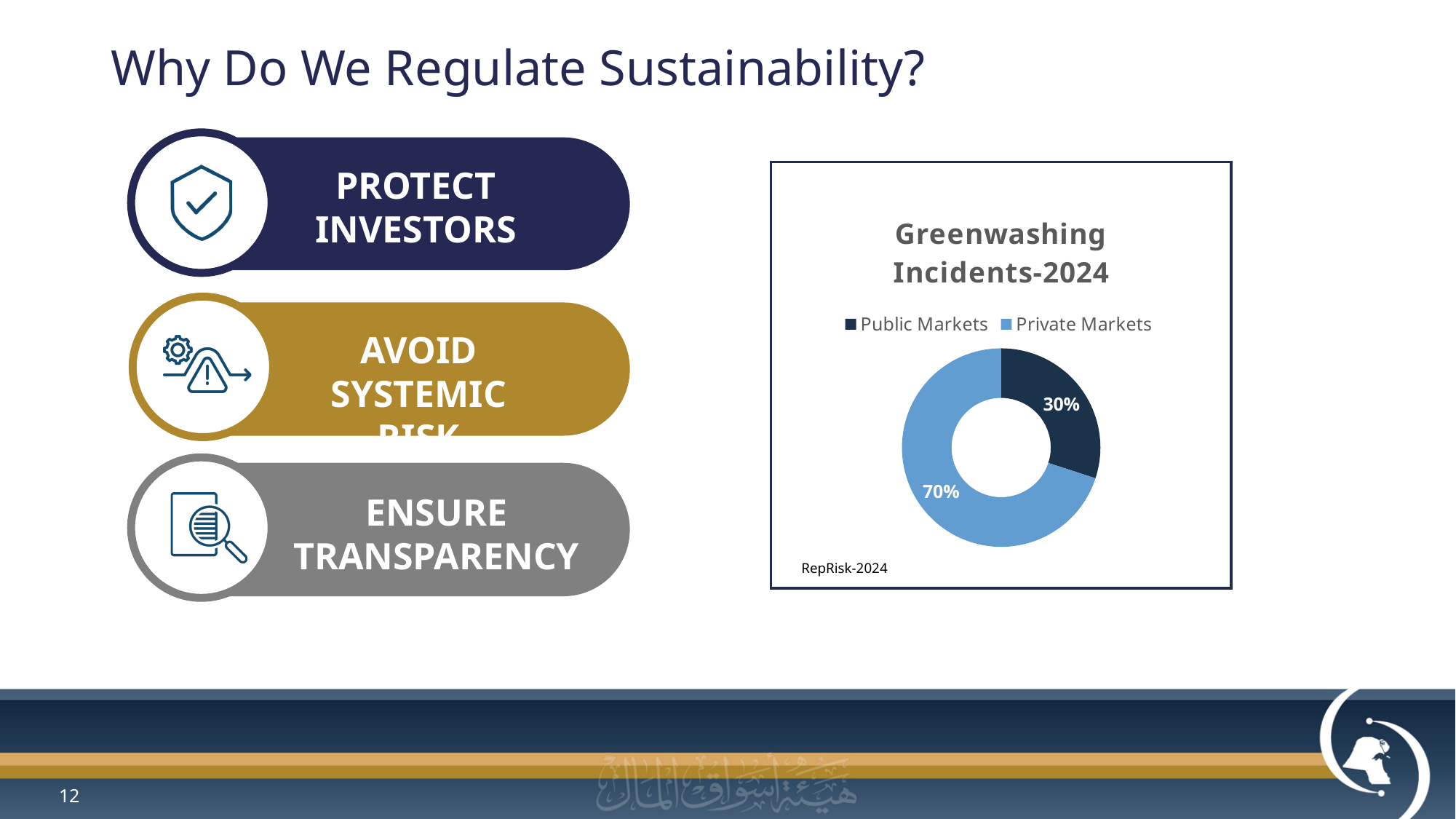
How many categories does the Greenwashing Incidents-2024 chart show? 2 What is the difference in percentage points between the Private Markets and Public Markets shares? 40 percentage points What source is cited below the Greenwashing Incidents-2024 chart? RepRisk-2024 What share of greenwashing incidents in 2024 is attributed to Public Markets? 30% Which category accounts for the smallest share of greenwashing incidents in 2024? Public Markets What kind of chart is used to show Greenwashing Incidents-2024? Doughnut (pie) chart Which category accounts for the largest share of greenwashing incidents in 2024? Private Markets What share of greenwashing incidents in 2024 is attributed to Private Markets? 70% Which is larger: the share for Public Markets or the share for Private Markets? Private Markets How many entries does the legend of the Greenwashing Incidents-2024 chart list? 2 What is the title of the chart on the slide? Greenwashing Incidents-2024 What is the combined share of Public Markets and Private Markets in the chart? 100%